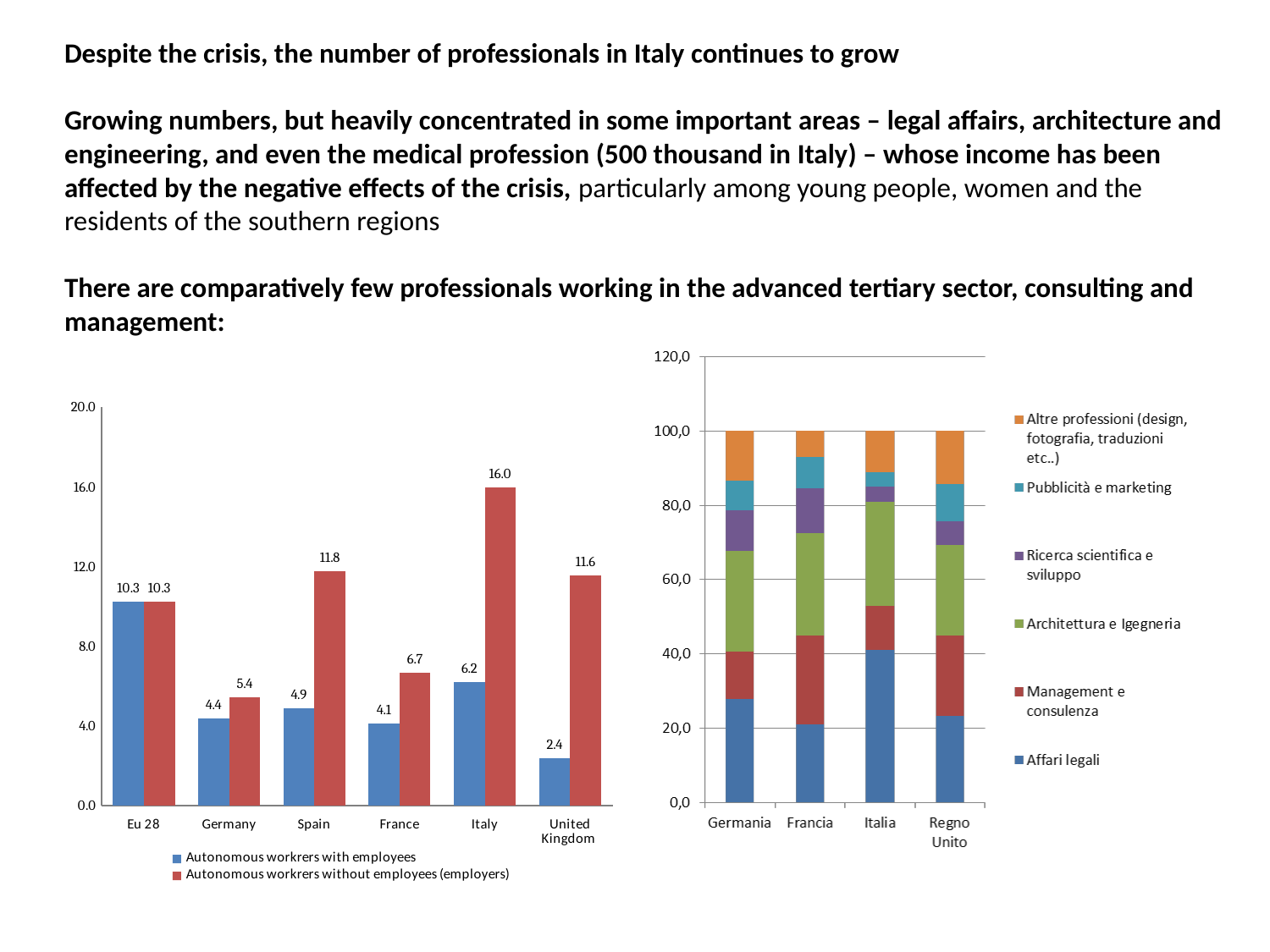
In the left chart, which category has the lowest value for 'Autonomous workrers with employees'? United Kingdom In the left chart, what is the difference between the two series' values for Spain? 6.9 In the right chart, which series is shown in orange at the top of each bar? Altre professioni (design, fotografia, traduzioni etc..) What kind of chart is the right chart? Stacked bar chart In the left chart, which country has the highest value for 'Autonomous workrers without employees (employers)'? Italy In the left chart, which is larger for France: the value with employees or the value without employees? Without employees (6.7) In the left chart, what is the value for Italy in the 'Autonomous workrers without employees (employers)' series? 16.0 In the left chart, what is the value for Germany in the 'Autonomous workrers with employees' series? 4.4 How many categories are shown on the x axis of the left chart? 6 In the right chart, which country has the largest 'Affari legali' segment? Italia In the right chart, is the value of 'Affari legali' for Germania greater or less than 40,0? less How many series does the legend of the right chart list? 6